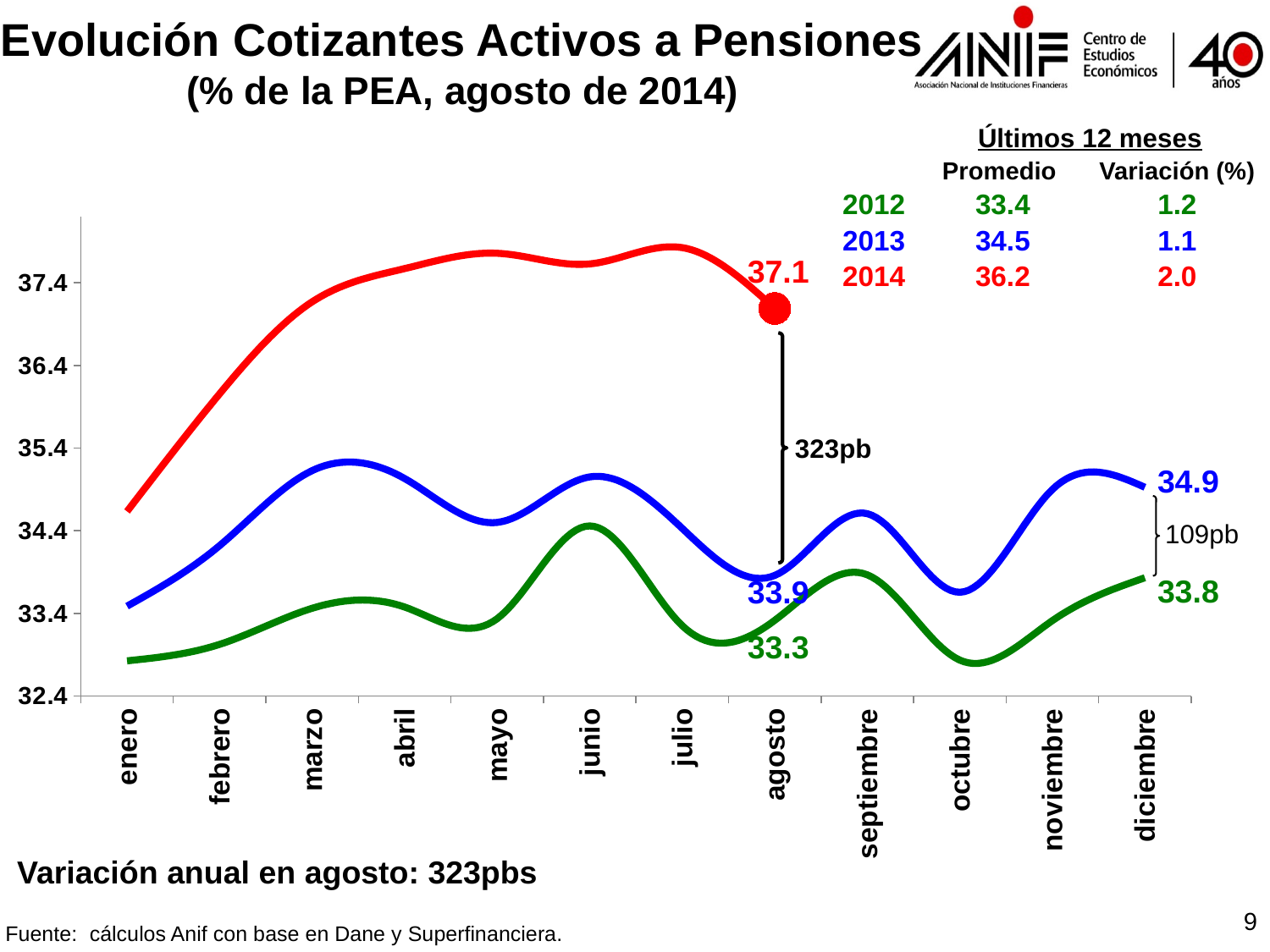
What is the value of the green 2012 line in agosto? 33.3 What is the difference between the 2013 and 2012 values in diciembre? 1.1 What type of chart is shown on the slide? line chart Which year's line has the lowest value in agosto? 2012 What is the value of the blue 2013 line in agosto? 33.9 What is the value of the blue 2013 line in diciembre? 34.9 What is the value of the green 2012 line in diciembre? 33.8 Is the value of the red 2014 line in enero greater or less than 35.4? less What is the value of the red 2014 line in agosto? 37.1 How many months are shown on the x axis? 12 According to the table, what is the 'Promedio' for 2014 in the last 12 months? 36.2 Which year's line has the highest value in agosto? 2014